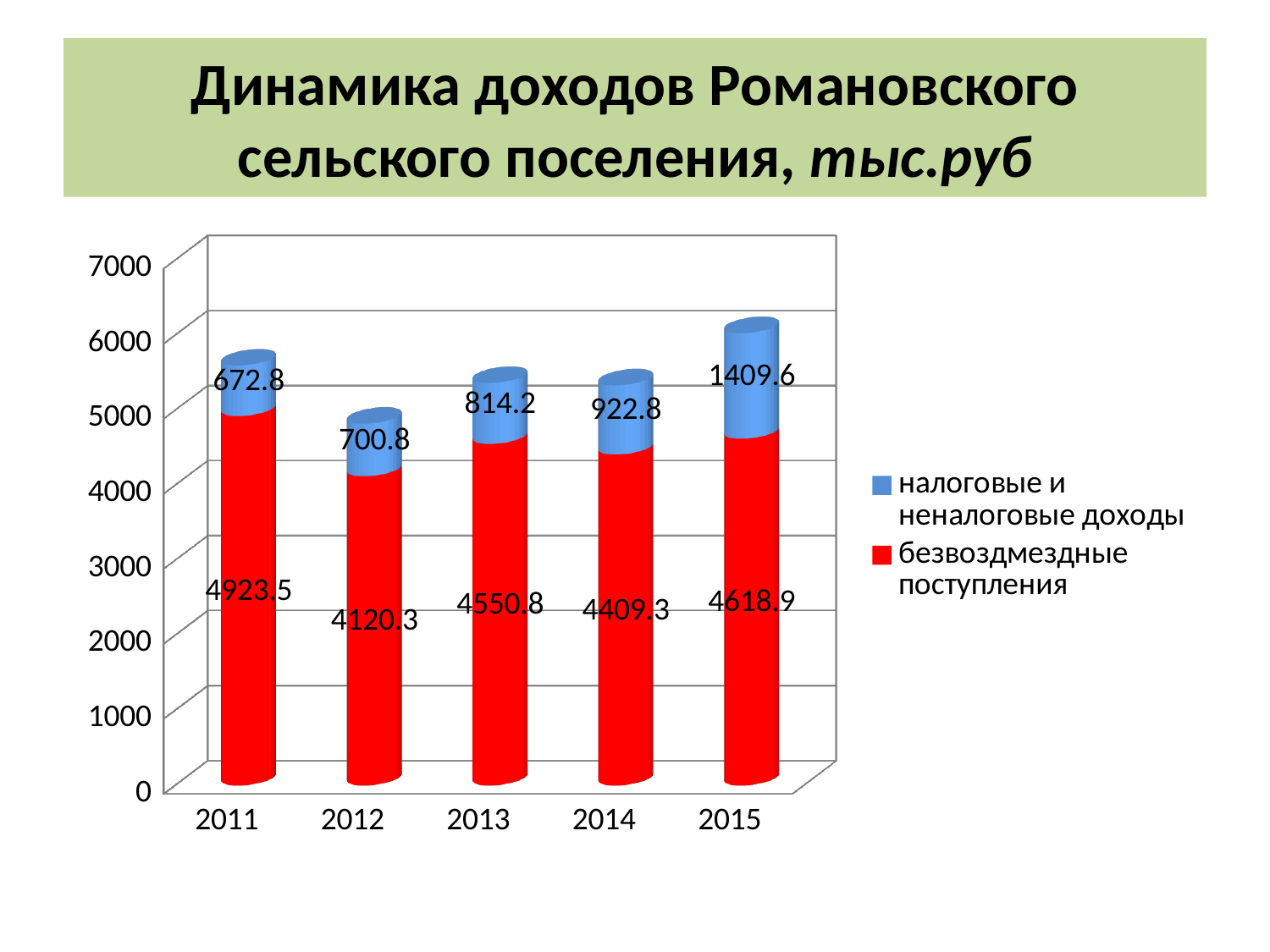
What is the value of налоговые и неналоговые доходы for 2015? 1409.6 What is the difference between безвозмездные поступления in 2011 and in 2012? 803.2 How many years are shown on the x axis? 5 How many series does the legend list? 2 What kind of chart is shown on the slide? Stacked bar chart Which is larger: налоговые и неналоговые доходы in 2014 or in 2012? 2014 In which year is the value of безвозмездные поступления the lowest? 2012 What is the total of the stacked bar for 2015? 6028.5 In which year is the value of налоговые и неналоговые доходы the highest? 2015 What is the value of налоговые и неналоговые доходы for 2013? 814.2 What is the total of the stacked bar for 2012? 4821.1 What is the value of безвозмездные поступления for 2011? 4923.5